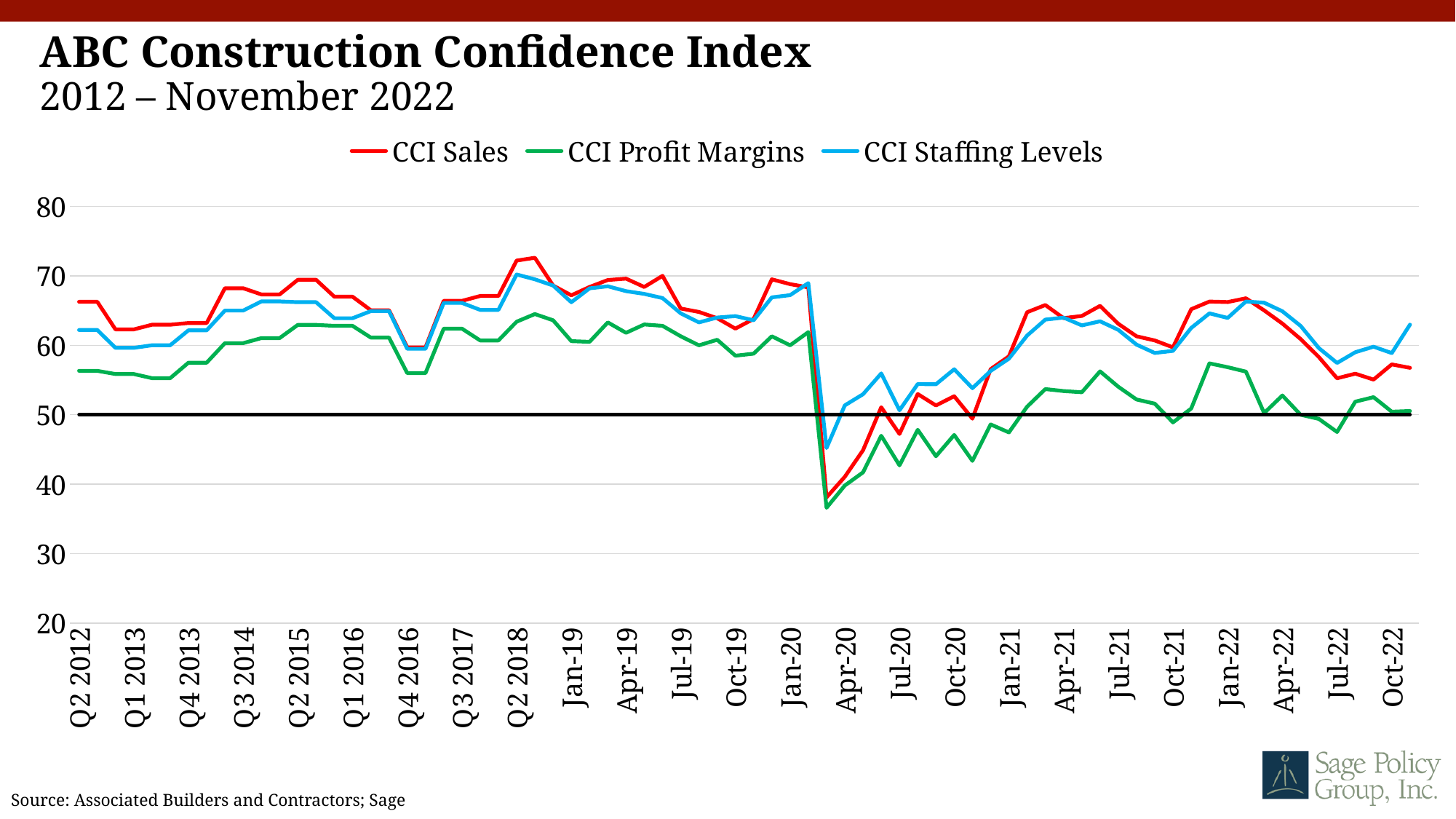
Is the value for CCI Profit Margins at Apr-20 greater or less than 50? less What is the title of the chart? ABC Construction Confidence Index How many series does the legend list? 3 Is the value for CCI Sales at Q2 2012 greater or less than 60? greater Which series has the lowest value at Q2 2018? CCI Profit Margins Between Jan-20 and Apr-20, does CCI Sales rise or fall? fall Is the value for CCI Sales at Q2 2018 greater or less than 70? greater At Q2 2012, which is higher, CCI Sales or CCI Profit Margins? CCI Sales What kind of chart is shown on the slide? line chart What are the three series named in the legend? CCI Sales, CCI Profit Margins, CCI Staffing Levels At Apr-20, which is higher, CCI Staffing Levels or CCI Profit Margins? CCI Staffing Levels